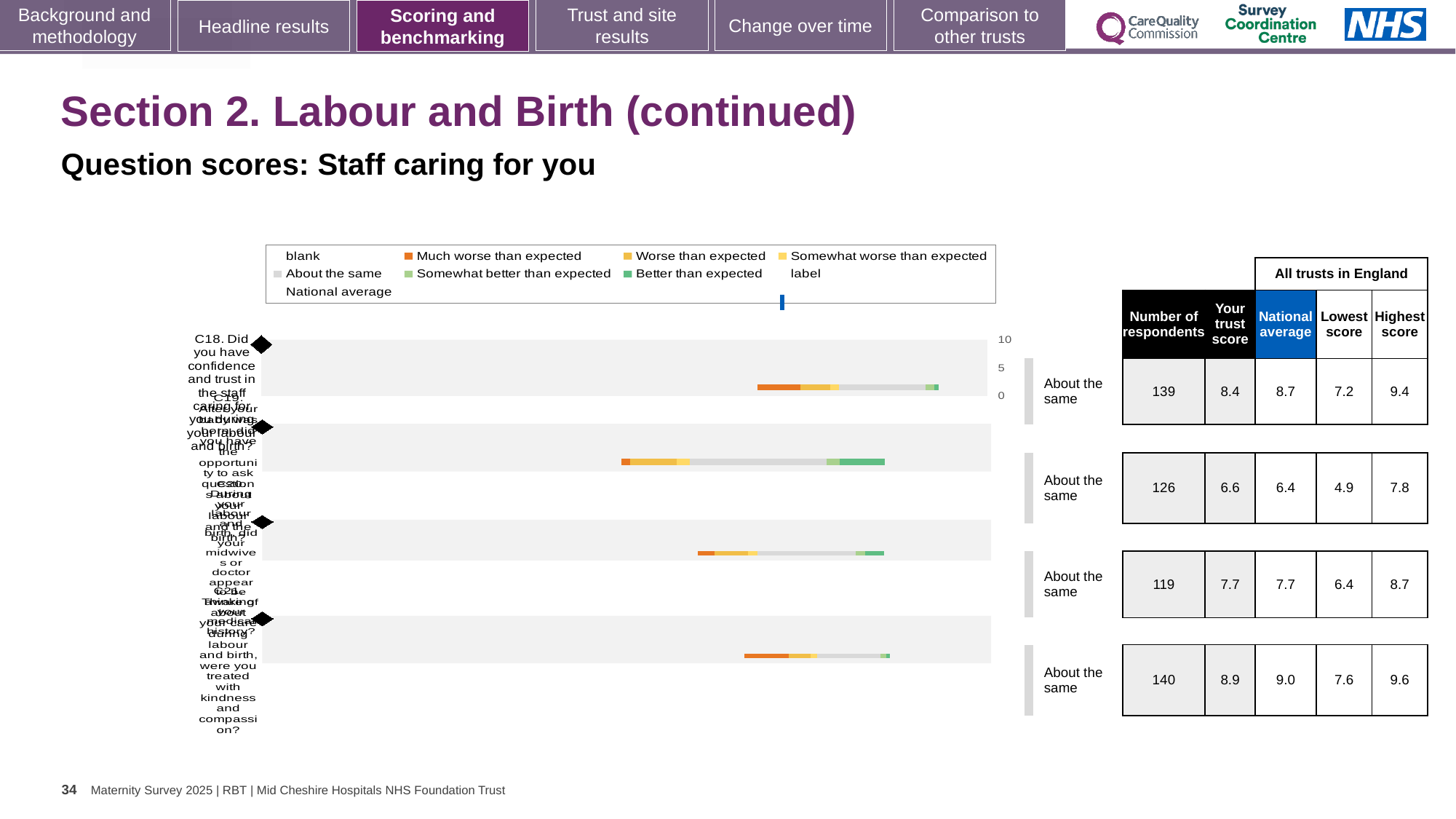
What kind of chart is shown on the slide? bar chart What is the trust score for question C19 (opportunity to ask questions about your labour and the birth)? 6.6 Which question has the lowest trust score? C19 How many questions (bars) are plotted in the chart? 4 What is the difference between the highest score and the lowest score for question C19? 2.9 Which legend entry is shown in dark orange? Much worse than expected What is the highest score across all trusts in England for question C20 (midwives or doctor aware of your medical history)? 8.7 Is the trust score for question C18 larger or smaller than the national average for C18? smaller What is the national average for question C21 (treated with kindness and compassion)? 9.0 What benchmark category is shown for question C20? About the same Which question has the highest number of respondents? C21 What is the number of respondents for question C18 (confidence and trust in the staff caring for you)? 139